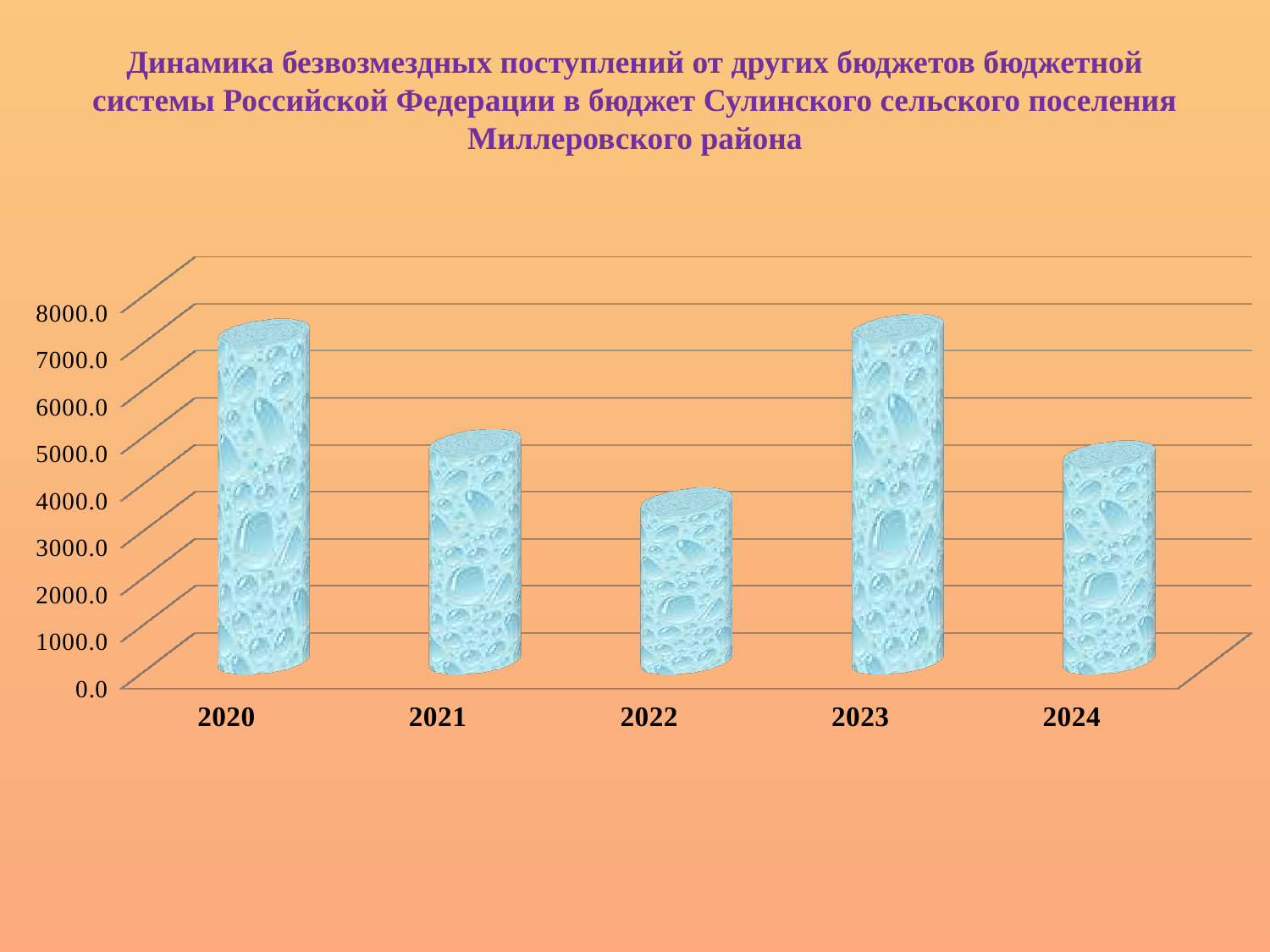
What kind of chart is shown on the slide? bar chart Which is larger, the value for 2021 or the value for 2022? 2021 Do the values rise or fall from 2020 to 2022? fall Is the value for 2024 greater or less than 4000? greater What is the first year shown on the x axis of the chart? 2020 Is the value for 2022 greater or less than 5000? less Is the value for 2021 greater or less than 6000? less How many years are shown on the x axis of the chart? 5 Which is larger, the value for 2020 or the value for 2024? 2020 Which year has the lowest value in the chart? 2022